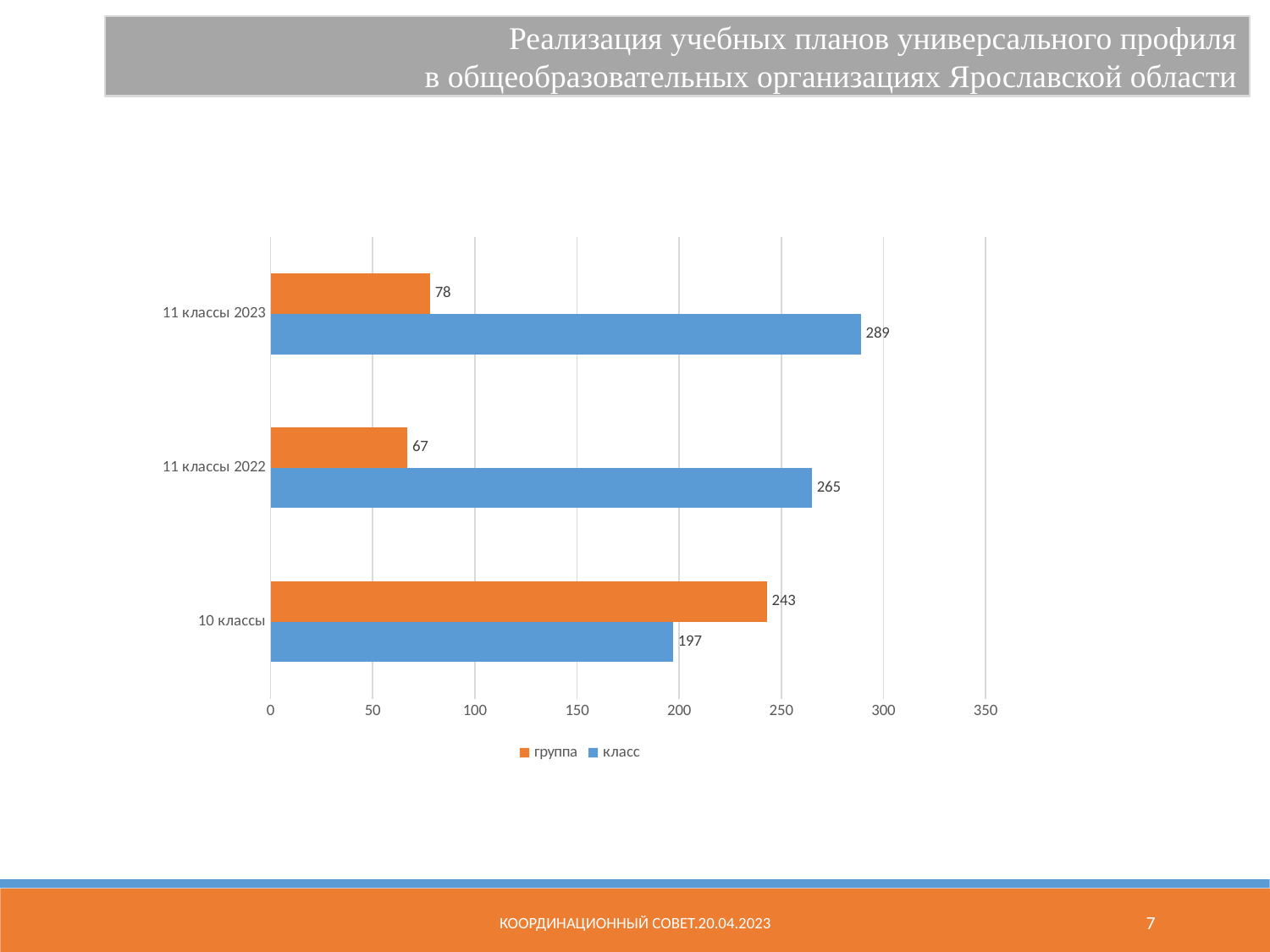
What is the difference between the 'класс' values for '11 классы 2023' and '11 классы 2022'? 24 What kind of chart is shown on the slide? bar chart How many categories are shown on the chart? 3 How many series does the legend list? 2 What is the value of the 'класс' series for '11 классы 2023'? 289 What is the value of the 'группа' series for '11 классы 2022'? 67 Which category has the lowest value in the 'группа' series? 11 классы 2022 What is the value of the 'группа' series for '10 классы'? 243 What colour represents the 'группа' series? orange Which category has the highest value in the 'класс' series? 11 классы 2023 For '10 классы', which series has the larger value, 'группа' or 'класс'? группа What is the value of the 'класс' series for '10 классы'? 197